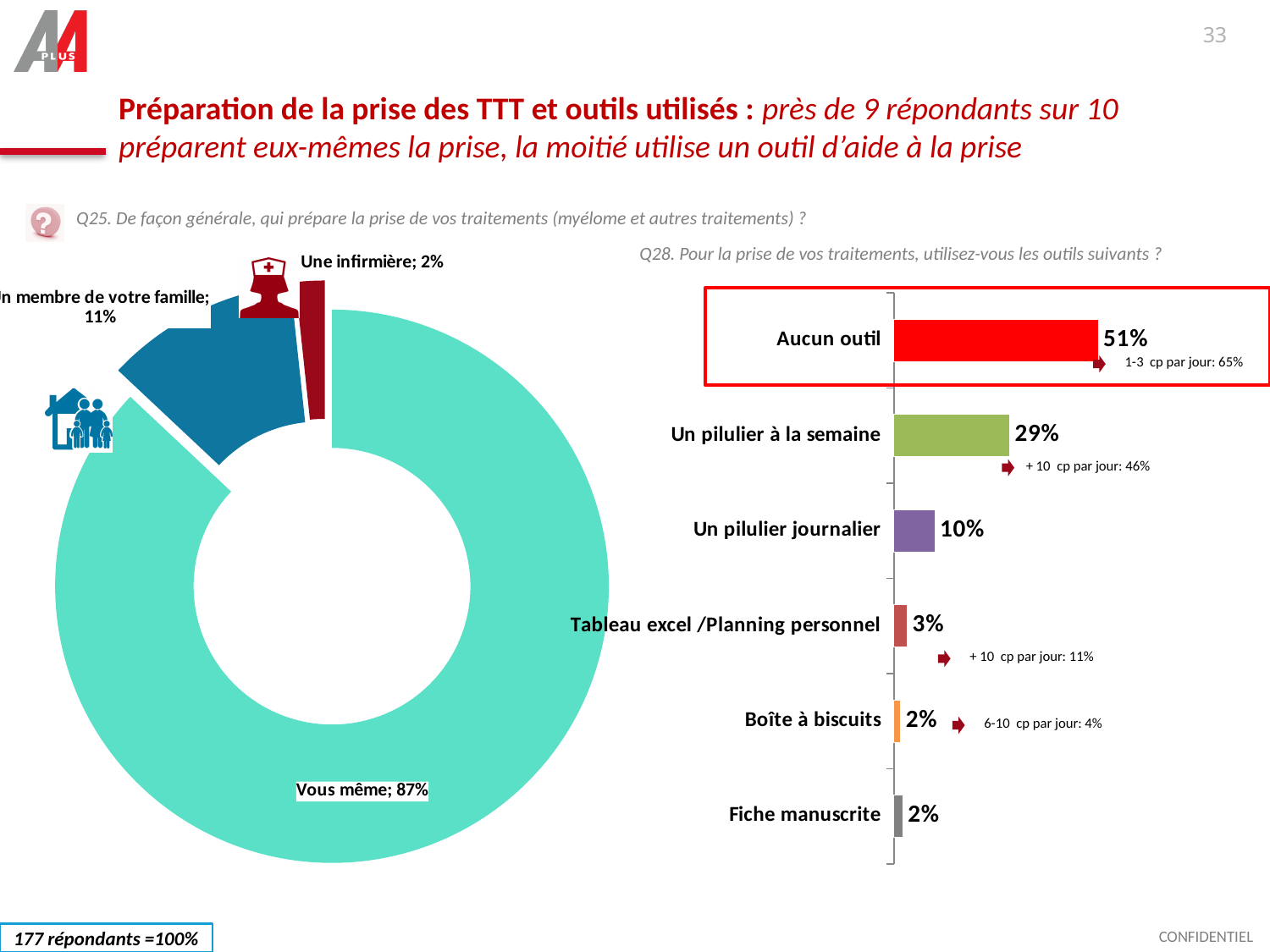
In the right chart (Q28), how many categories are shown? 6 What kind of chart is the left chart (Q25)? Pie (donut) chart In the right chart (Q28), which category has the highest value? Aucun outil In the right chart (Q28), what is the difference between 'Aucun outil' and 'Un pilulier à la semaine'? 22% In the right chart (Q28), what is the value for 'Un pilulier journalier'? 10% In the right chart (Q28), what is the value for 'Aucun outil'? 51% In the left chart (Q25), what share of respondents answered 'Vous même'? 87% In the right chart (Q28), what is the value for 'Un pilulier à la semaine'? 29% In the left chart (Q25), which category has the smallest share? Une infirmière In the left chart (Q25), what is the value for 'Une infirmière'? 2% In the left chart (Q25), what is the value for 'Un membre de votre famille'? 11% What kind of chart is the right chart (Q28)? Bar chart